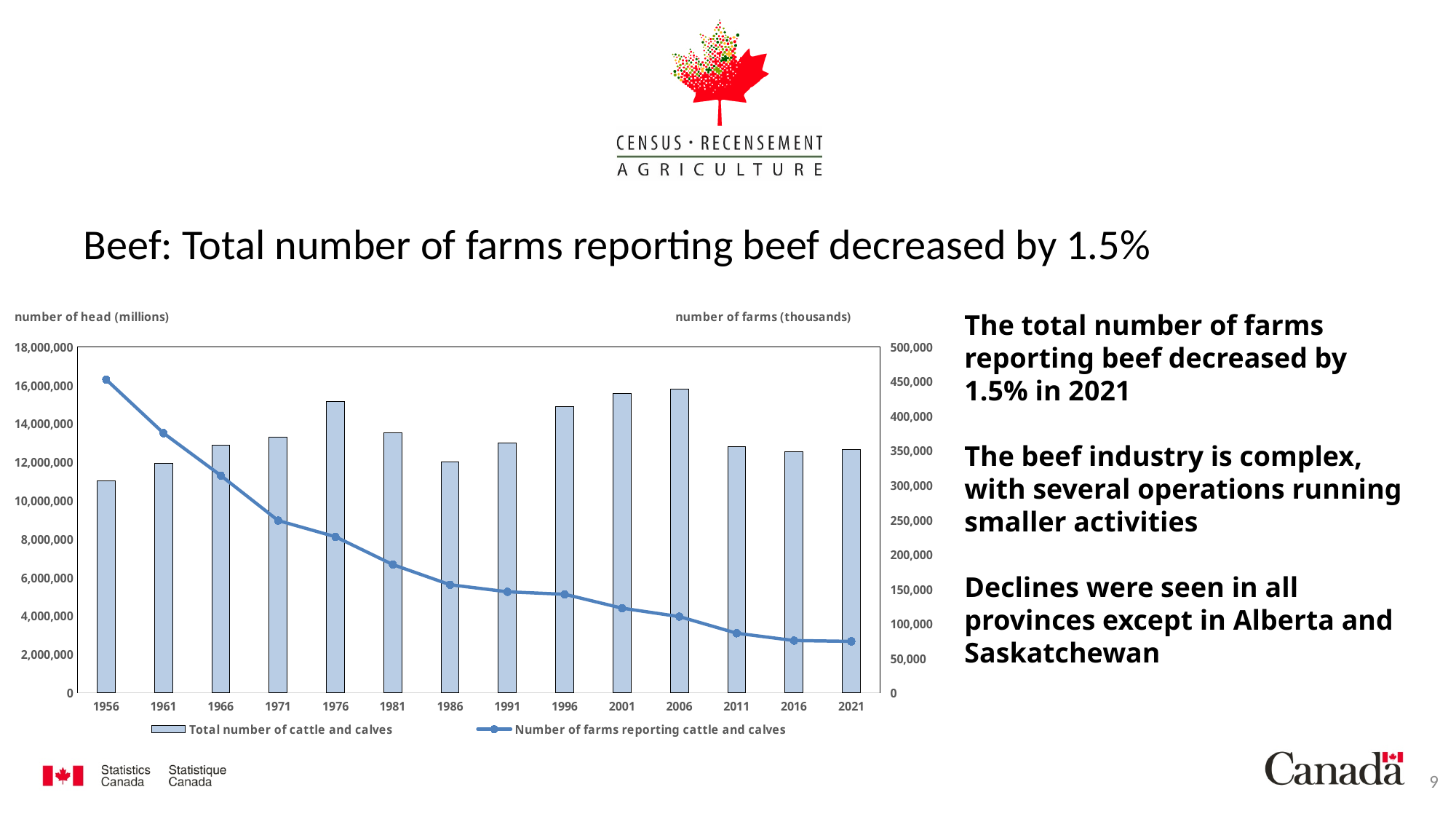
In which year is the number of farms reporting cattle and calves highest? 1956 What is the label of the left vertical axis of the chart? number of head (millions) Which year has the lowest bar for total number of cattle and calves? 1956 Does the number of farms reporting cattle and calves rise or fall from 1956 to 2021? Fall Is the number of farms reporting cattle and calves in 2021 greater or less than 100,000? less Is the total number of cattle and calves in 1956 greater or less than 12,000,000? less What kind of chart is shown on the slide? A combined bar and line chart Is the total number of cattle and calves in 1976 greater or less than 14,000,000? greater Which year has the larger total number of cattle and calves, 1976 or 1981? 1976 How many series does the chart legend list? 2 How many census years are shown on the x axis of the chart? 14